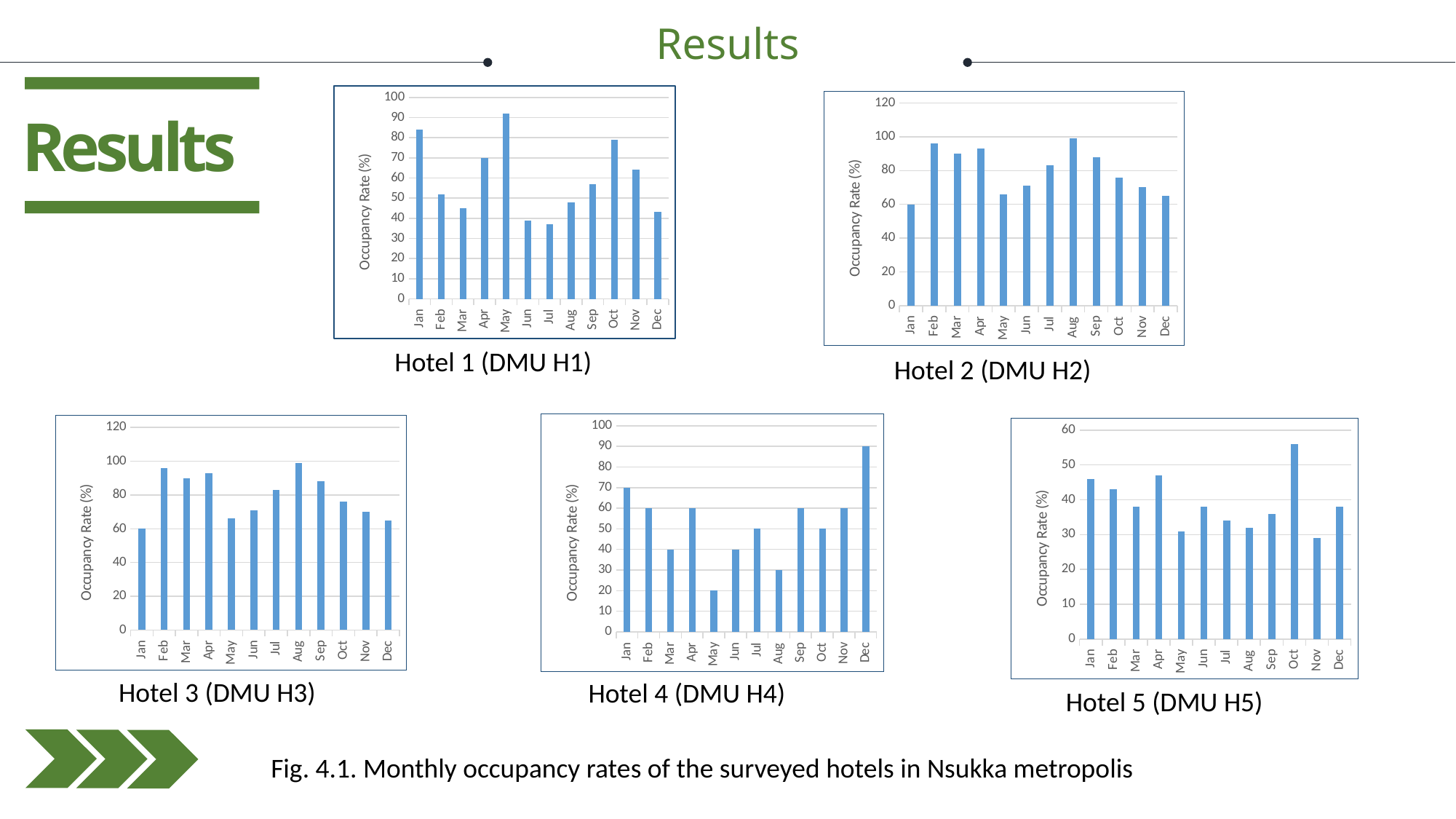
What kind of chart is used for Hotel 3 (DMU H3)? Bar chart In the Hotel 3 (DMU H3) chart, which month has the highest occupancy rate? Aug In the Hotel 4 (DMU H4) chart, which is larger, the value for Jan or the value for Feb? Jan In the Hotel 4 (DMU H4) chart, what is the difference between the Dec and May occupancy rates? 70 In the Hotel 1 (DMU H1) chart, which month has the highest occupancy rate? May In the Hotel 4 (DMU H4) chart, what is the occupancy rate for Dec? 90 In the Hotel 2 (DMU H2) chart, is the value for Feb greater or less than 80? greater In the Hotel 4 (DMU H4) chart, which month has the lowest occupancy rate? May How many months are plotted on the x axis of the Hotel 5 (DMU H5) chart? 12 In the Hotel 2 (DMU H2) chart, which month has the highest occupancy rate? Aug In the Hotel 1 (DMU H1) chart, is the value for Oct greater or less than 70? greater